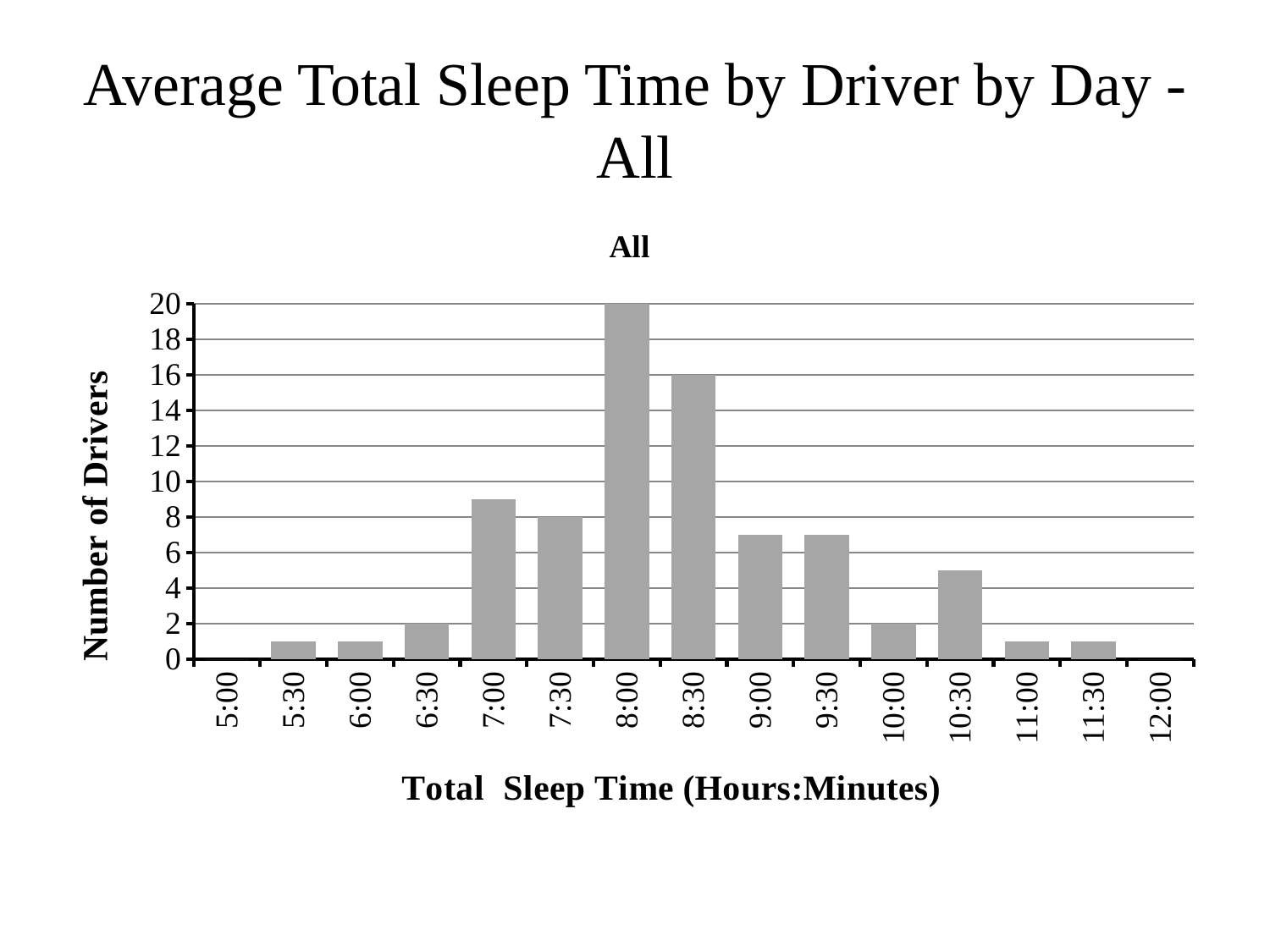
How many drivers are shown for a total sleep time of 6:30? 2 What is the label of the y axis? Number of Drivers What type of chart is shown on the slide? bar chart Is the number of drivers for 10:30 greater or less than 4? greater How many drivers are shown for a total sleep time of 7:30? 8 Which has more drivers, the 7:30 category or the 8:30 category? 8:30 How many total sleep time categories are shown on the x axis? 15 How many drivers are shown for a total sleep time of 8:00? 20 Which total sleep time category has the highest number of drivers? 8:00 Is the number of drivers for 7:00 greater or less than 10? less How many drivers are shown for a total sleep time of 8:30? 16 What is the difference in number of drivers between the 8:00 and 8:30 categories? 4